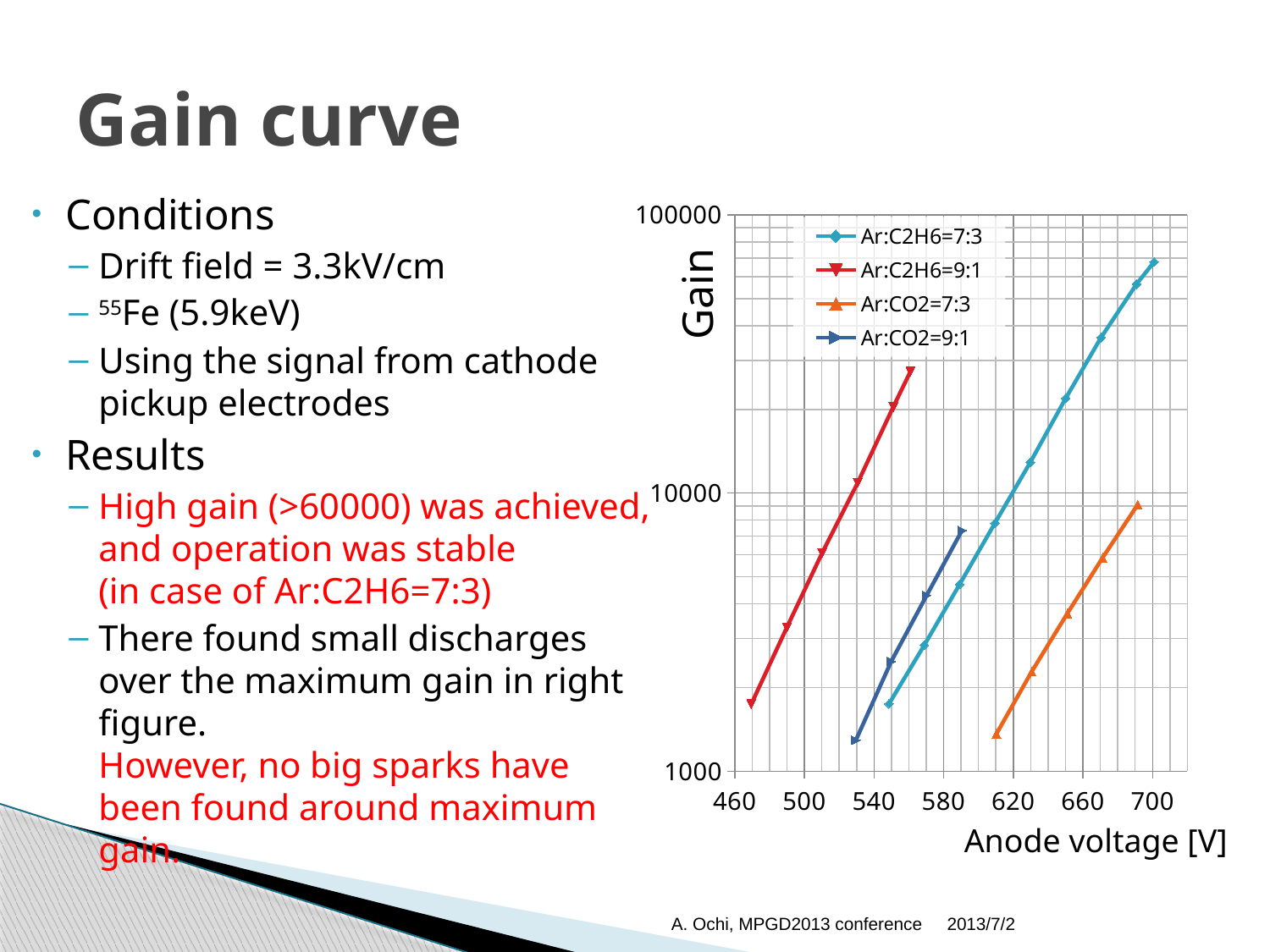
What is the label of the y axis of the chart? Gain Does the gain for each series rise or fall as the anode voltage increases? rise Which series reaches the highest gain on the chart? Ar:C2H6=7:3 What kind of chart is shown on the slide? line chart How many series does the legend of the gain curve chart list? 4 Is the gain for Ar:C2H6=7:3 at 700 V greater or less than 10000? greater Is the gain for Ar:CO2=7:3 at 610 V greater or less than 10000? less What is the label of the x axis of the chart? Anode voltage [V] At 550 V, which series has the higher gain: Ar:C2H6=9:1 or Ar:C2H6=7:3? Ar:C2H6=9:1 Is the gain for Ar:CO2=9:1 at 590 V greater or less than 10000? less Which series is measured at the lowest anode voltages on the chart? Ar:C2H6=9:1